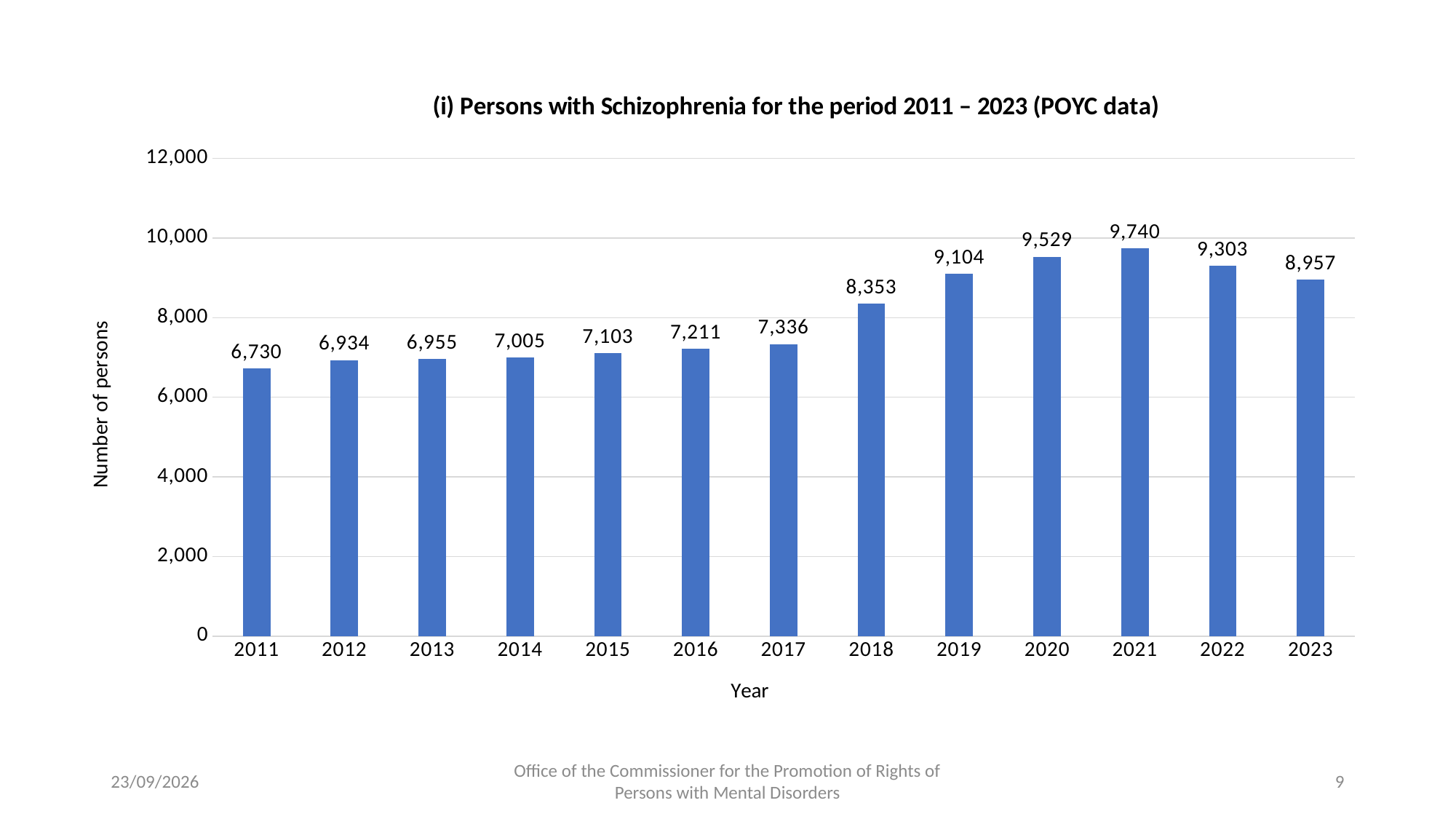
Which year has the highest number of persons with schizophrenia? 2021 What kind of chart is shown on the slide? bar chart What is the number of persons with schizophrenia in 2011? 6,730 What is the difference between the number of persons in 2021 and in 2023? 783 What is the title of the chart? (i) Persons with Schizophrenia for the period 2011 – 2023 (POYC data) Is the value for 2019 greater or less than 10,000? less What is the number of persons with schizophrenia in 2018? 8,353 Which year has the lowest number of persons with schizophrenia? 2011 Which year has more persons with schizophrenia, 2020 or 2022? 2020 How many years are shown on the x axis of the chart? 13 Do the values rise or fall from 2011 to 2021? rise What is the label of the y axis? Number of persons